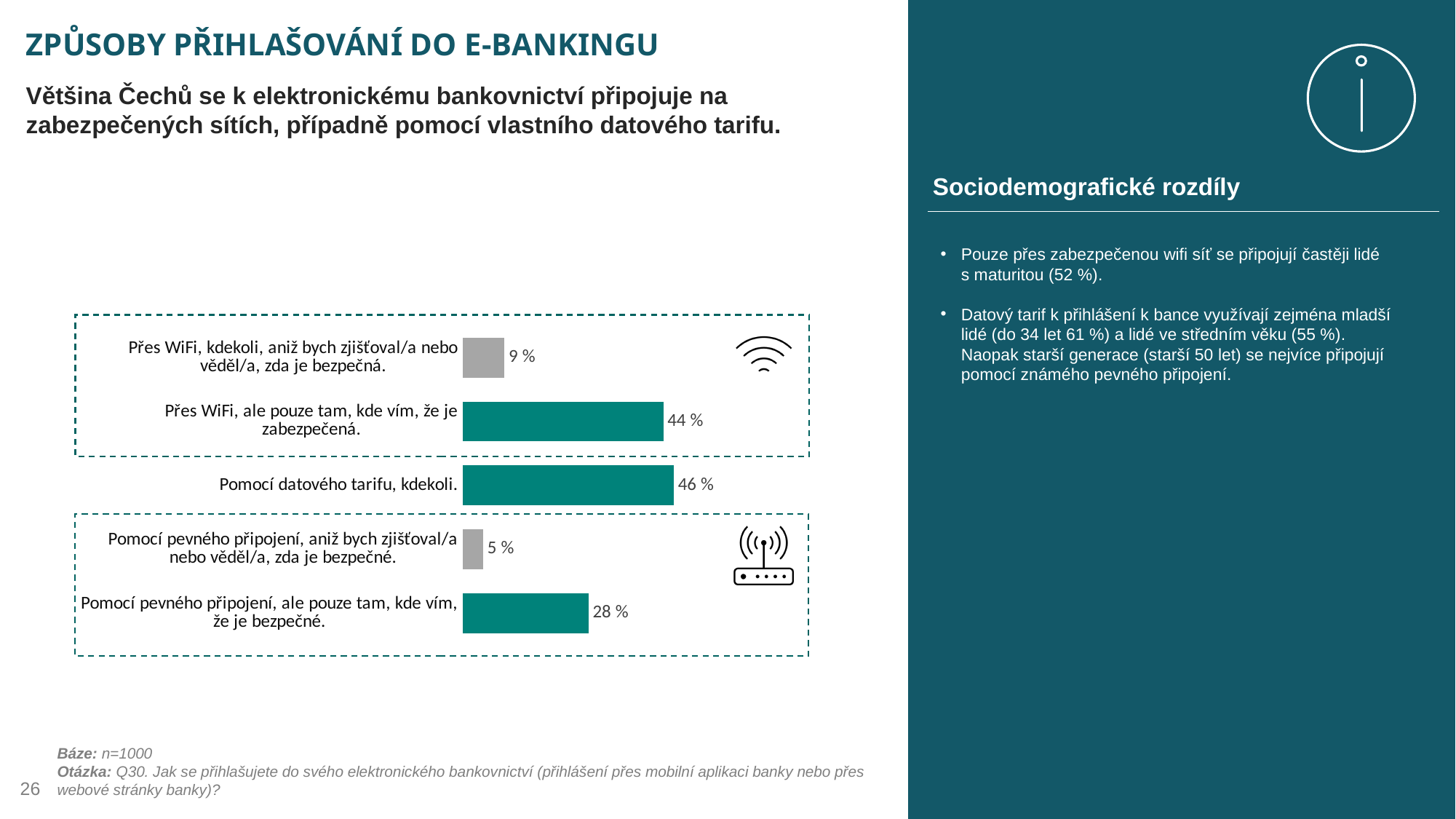
What is the difference between "Pomocí pevného připojení, ale pouze tam, kde vím, že je bezpečné." and "Pomocí pevného připojení, aniž bych zjišťoval/a nebo věděl/a, zda je bezpečné."? 23 % What is the difference between "Přes WiFi, ale pouze tam, kde vím, že je zabezpečená." and "Přes WiFi, kdekoli, aniž bych zjišťoval/a nebo věděl/a, zda je bezpečná."? 35 % What is the base (Báze) stated for the chart? n=1000 Which category has the highest value? Pomocí datového tarifu, kdekoli. Which is larger: "Přes WiFi, kdekoli, aniž bych zjišťoval/a nebo věděl/a, zda je bezpečná." or "Pomocí pevného připojení, ale pouze tam, kde vím, že je bezpečné."? Pomocí pevného připojení, ale pouze tam, kde vím, že je bezpečné. How many categories does the chart show? 5 Which category has the lowest value? Pomocí pevného připojení, aniž bych zjišťoval/a nebo věděl/a, zda je bezpečné. What kind of chart is shown on the slide? Bar chart What is the value for "Pomocí pevného připojení, aniž bych zjišťoval/a nebo věděl/a, zda je bezpečné."? 5 % What is the value for "Pomocí pevného připojení, ale pouze tam, kde vím, že je bezpečné."? 28 % What is the value for "Pomocí datového tarifu, kdekoli."? 46 % What is the value for "Přes WiFi, ale pouze tam, kde vím, že je zabezpečená."? 44 %